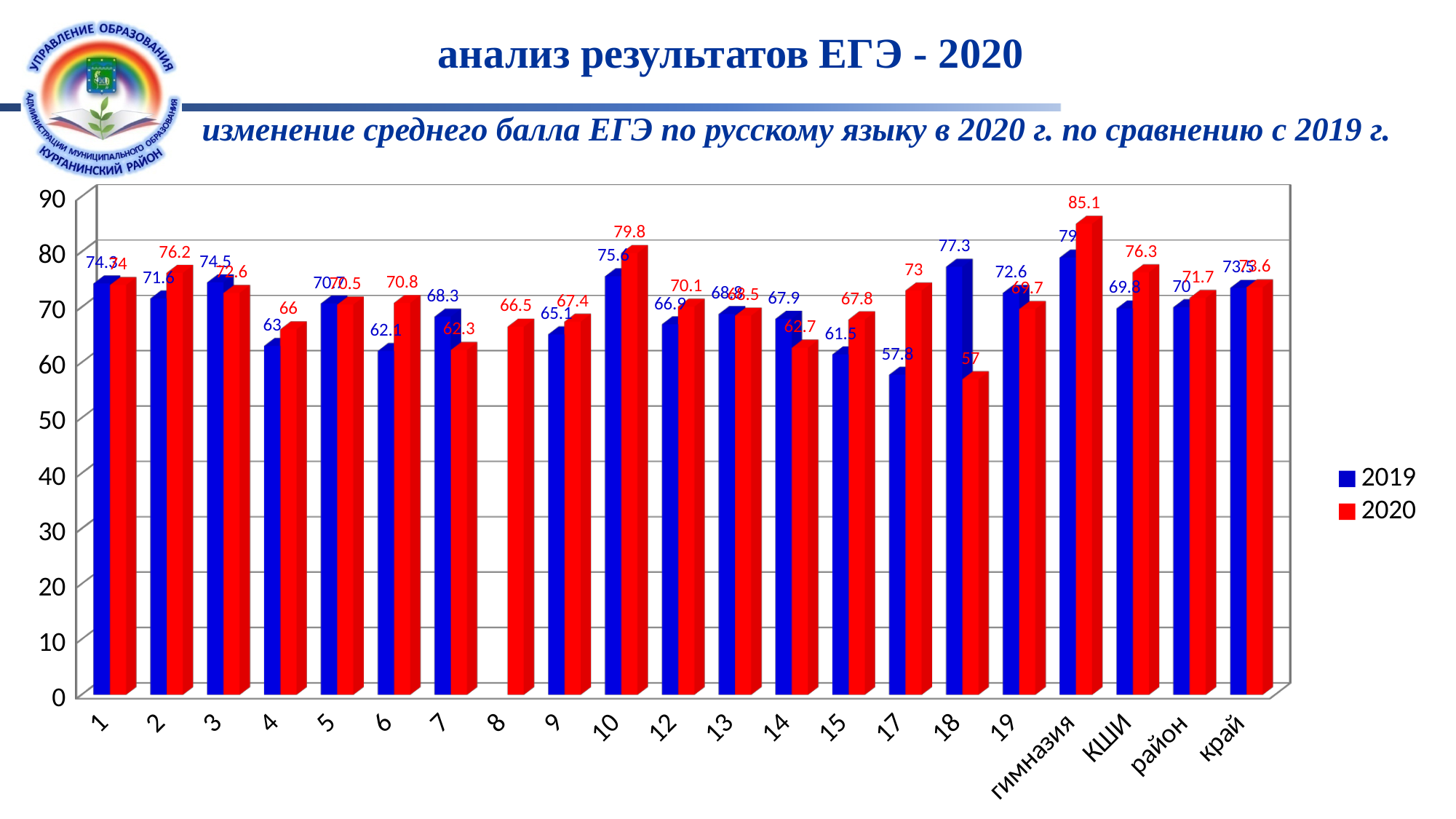
How many categories are shown on the x axis? 21 What is the 2020 value for гимназия? 85.1 For category 6, which year has the larger value, 2019 or 2020? 2020 Which category has the highest 2020 value? гимназия Which category has the lowest 2019 value? 17 Is the 2019 value for category 15 greater or less than 70? less What is the difference between the 2020 and 2019 values for category 17? 15.2 What is the 2020 value for category 8? 66.5 How many series does the legend list? 2 What is the 2019 value for category 18? 77.3 What is the 2019 value for КШИ? 69.8 Which category has the lowest 2020 value? 18